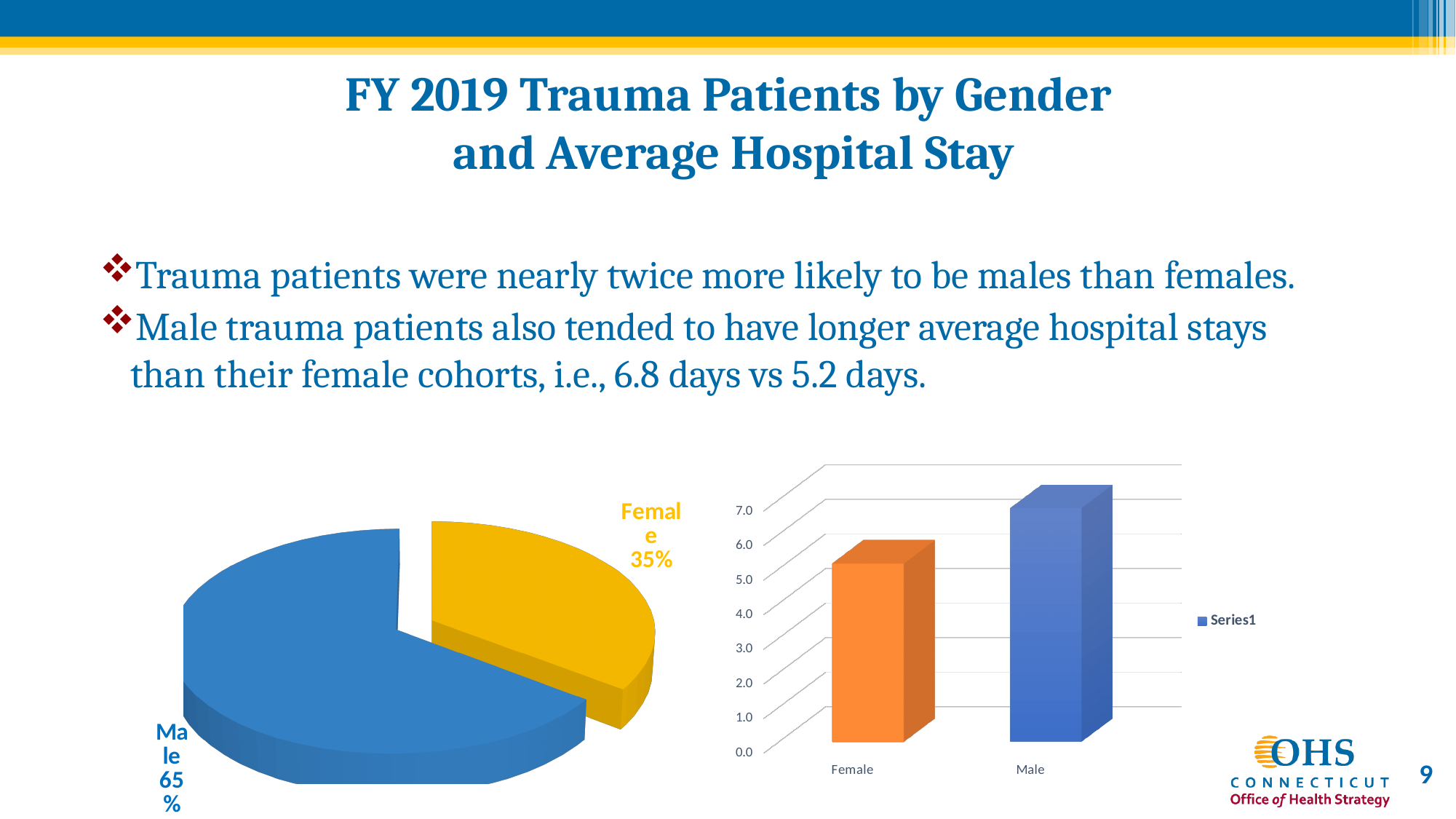
On the pie chart on the left, what is the difference in percentage points between the Male and Female slices? 30 percentage points On the bar chart on the right, which category has the taller bar, Female or Male? Male On the pie chart on the left, what percentage of trauma patients were male? 65% On the pie chart on the left, what percentage of trauma patients were female? 35% On the pie chart on the left, which gender has the smaller slice? Female What kind of chart is the chart on the right of the slide? Bar chart On the bar chart on the right, is the value for Male greater or less than 6.0? greater How many slices does the pie chart on the left have? 2 On the bar chart on the right, is the value for Female greater or less than 6.0? less How many series does the legend of the bar chart on the right list? 1 What kind of chart is the chart on the left of the slide? Pie chart On the pie chart on the left, which gender has the larger slice? Male